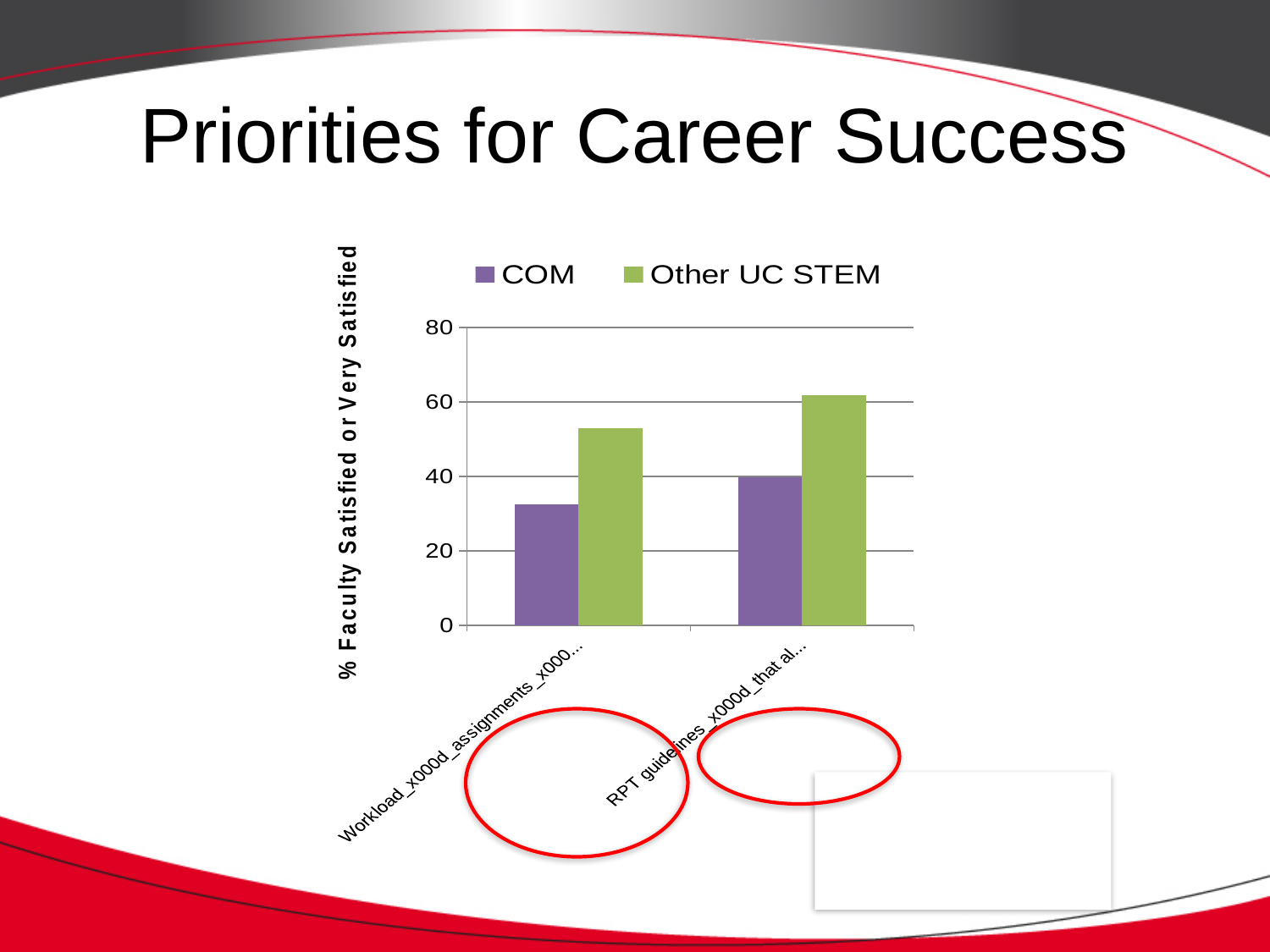
Is the COM value for the Workload category greater or less than 40? less What is the title of the vertical axis? % Faculty Satisfied or Very Satisfied How many series does the legend list? 2 How many categories are plotted on the x axis? 2 Which series has the taller bar in the Workload category, COM or Other UC STEM? Other UC STEM Which series has the taller bar in the RPT guidelines category, COM or Other UC STEM? Other UC STEM Is the COM value for the RPT guidelines category greater or less than 60? less Which bar is the shortest in the chart? COM for Workload Is the Other UC STEM value for the Workload category greater or less than 40? greater What kind of chart is shown on the slide? bar chart What colour are the COM bars? purple Which bar is the tallest in the chart? Other UC STEM for RPT guidelines